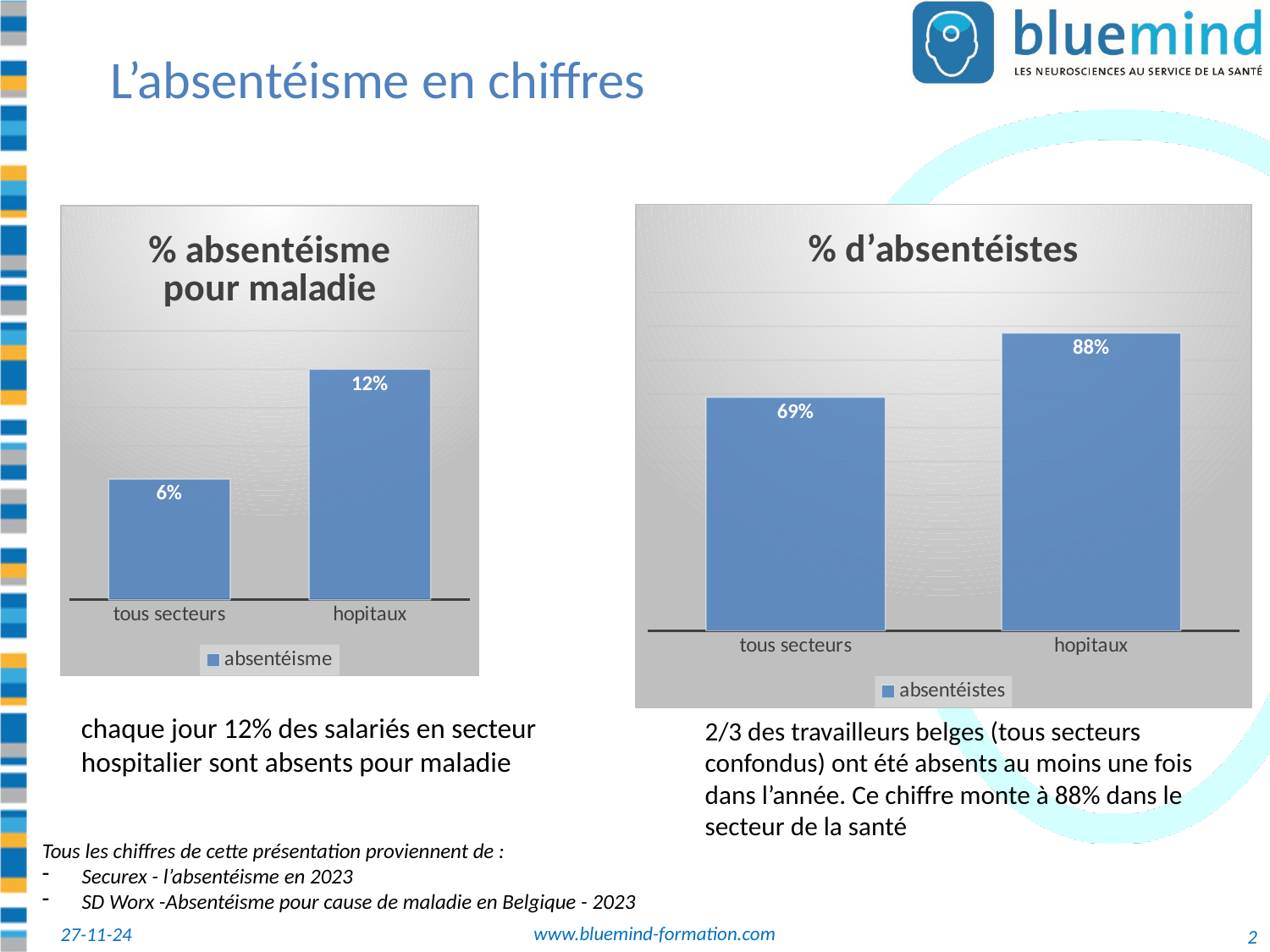
In the '% absentéisme pour maladie' chart, which category has the highest value? hopitaux How many categories are shown in the '% absentéisme pour maladie' chart? 2 What series name does the legend of the '% d'absentéistes' chart show? absentéistes In the '% d'absentéistes' chart, what is the value for hopitaux? 88% In the '% absentéisme pour maladie' chart, what is the difference between the values for hopitaux and tous secteurs? 6% In the '% d'absentéistes' chart, what is the value for tous secteurs? 69% In the '% absentéisme pour maladie' chart, what is the value for hopitaux? 12% In the '% absentéisme pour maladie' chart, what is the value for tous secteurs? 6% In the '% d'absentéistes' chart, what is the difference between the values for hopitaux and tous secteurs? 19% In the '% d'absentéistes' chart, which category has the lowest value? tous secteurs What kind of chart is the '% d'absentéistes' chart? bar chart In the '% d'absentéistes' chart, which is larger, the value for tous secteurs or the value for hopitaux? hopitaux